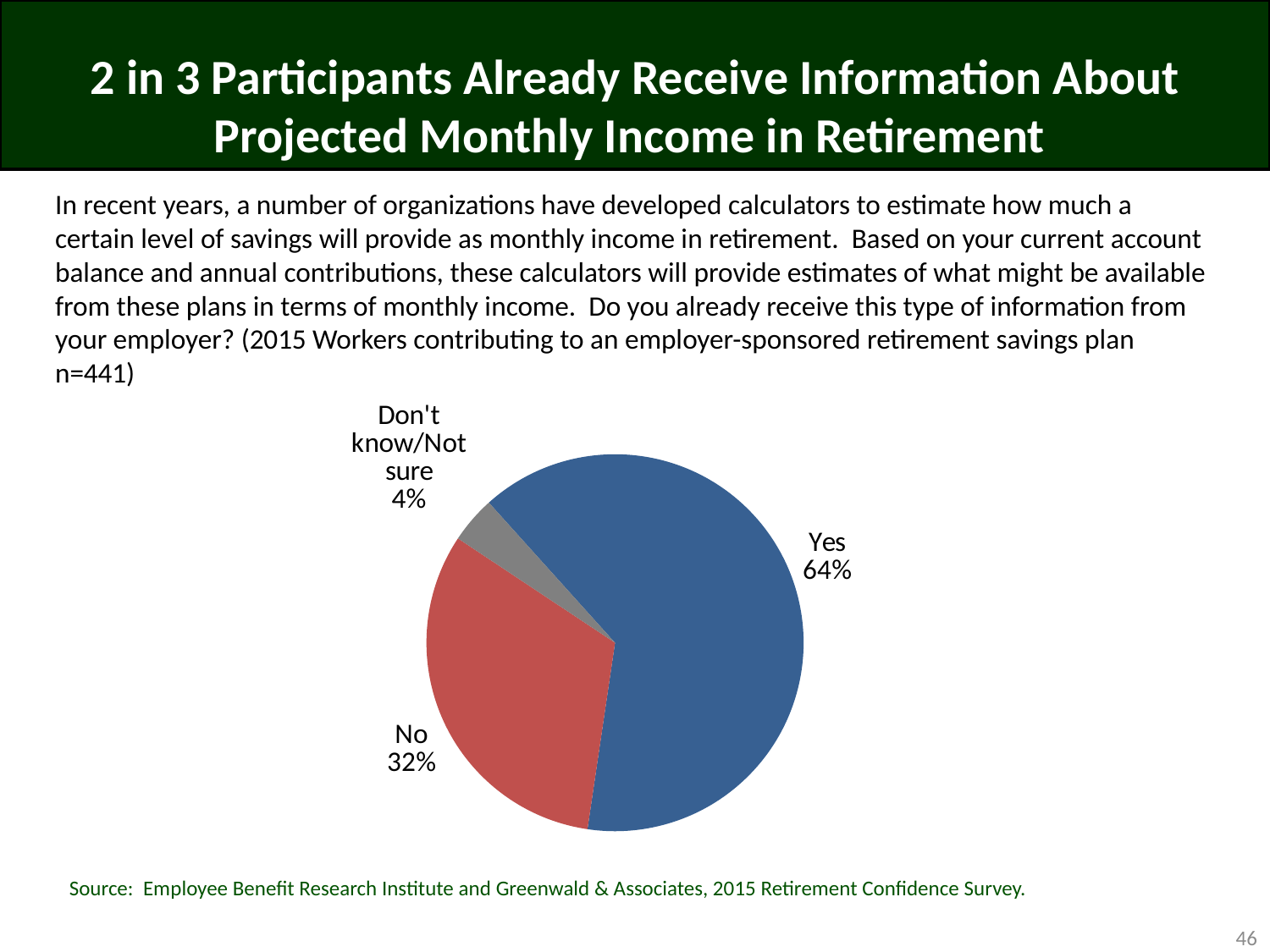
What percentage of participants answered "Don't know/Not sure"? 4% Which slice is larger, "No" or "Don't know/Not sure"? No Which response has the largest share of the pie? Yes What is the sample size (n) stated for the survey question shown on the slide? 441 Which response has the smallest share of the pie? Don't know/Not sure What share of the pie does the "No" slice represent? 32% What kind of chart is shown on the slide? pie chart What colour is the "Yes" slice? blue What percentage of participants answered "No"? 32% What is the difference in percentage points between the "Yes" and "No" slices? 32 How many slices does the pie chart have? 3 What percentage of participants answered "Yes"? 64%